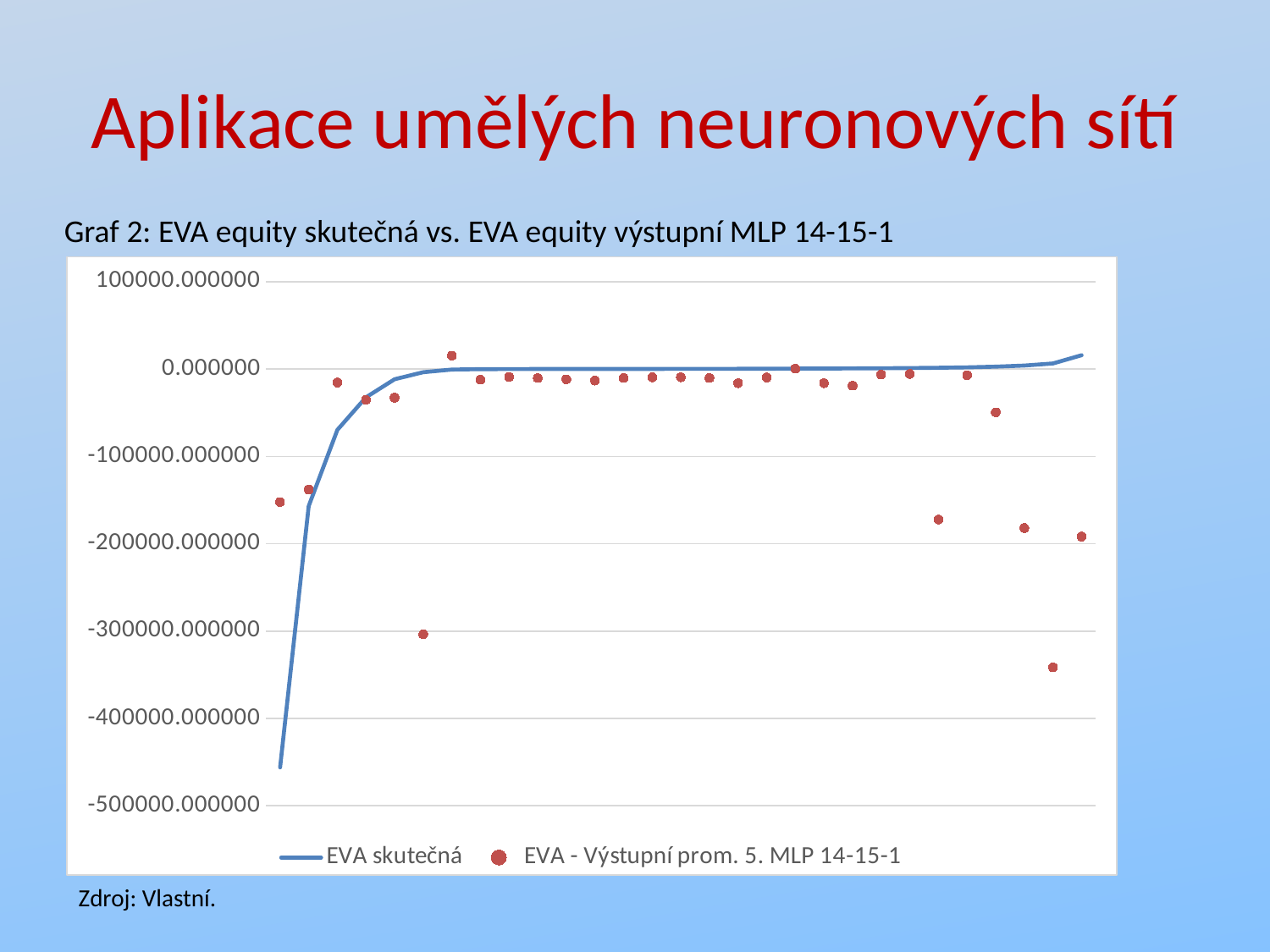
Is the lowest value of the EVA skutečná line greater or less than -400000? less Which series reaches the lowest value on the chart, EVA skutečná or EVA - Výstupní prom. 5. MLP 14-15-1? EVA skutečná Is the highest value of the EVA skutečná line greater or less than 100000? less How many series does the chart legend list? 2 Is the first (leftmost) red point of the EVA - Výstupní prom. 5. MLP 14-15-1 series greater or less than -100000? less What is the title of the chart? Graf 2: EVA equity skutečná vs. EVA equity výstupní MLP 14-15-1 Which series is drawn as a blue line? EVA skutečná Does the EVA skutečná line rise or fall along the x axis overall? rise What is the lowest tick label shown on the y axis? -500000.000000 What kind of chart is shown on the slide? line chart with scatter points